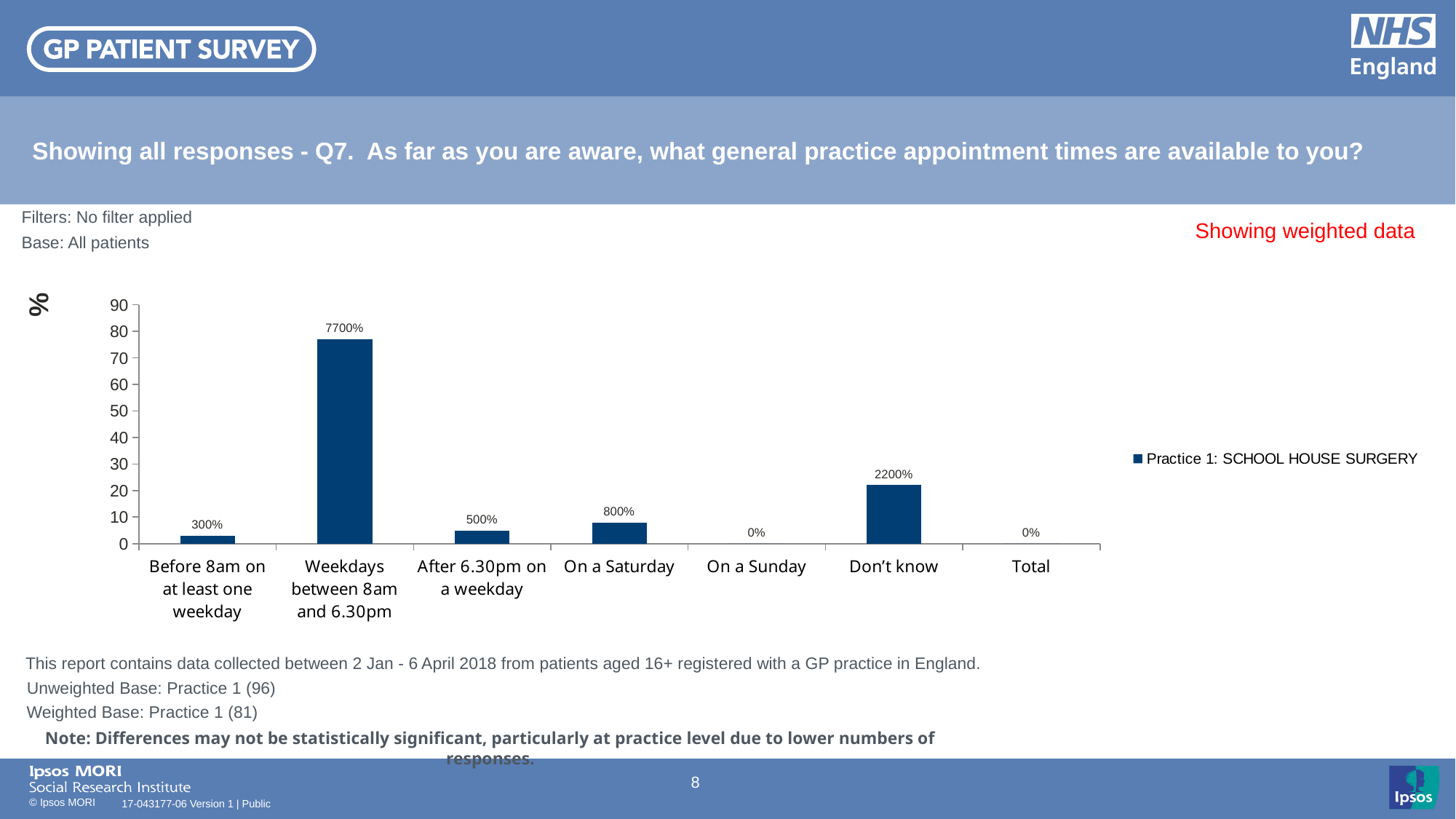
What is the data label shown for "Don't know"? 2200% Which category has the tallest bar? Weekdays between 8am and 6.30pm What is the legend entry for the series shown? Practice 1: SCHOOL HOUSE SURGERY Is the bar for "Don't know" above or below the 30 mark on the axis? below What is the data label shown for "On a Saturday"? 800% What is the data label shown for "On a Sunday"? 0% How many categories are shown on the x axis? 7 What is the data label shown for "Before 8am on at least one weekday"? 300% Which bar is taller: "After 6.30pm on a weekday" or "On a Saturday"? On a Saturday What type of chart is shown on the slide? bar chart How many series does the legend list? 1 What is the data label shown for "Weekdays between 8am and 6.30pm"? 7700%